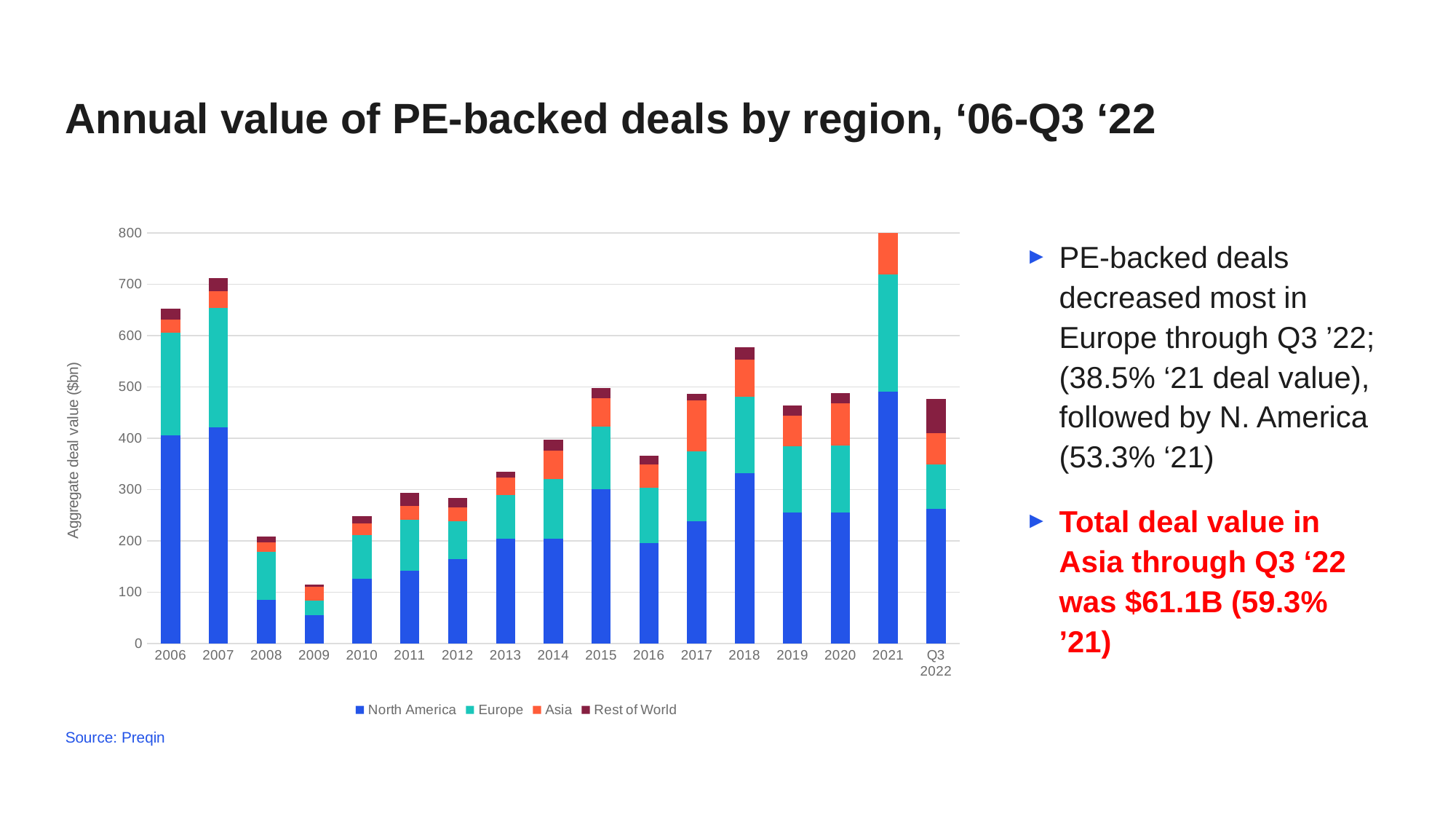
What kind of chart is shown on the slide? Stacked bar chart How many series does the legend list? 4 Do total deal values rise or fall from 2009 to 2015? rise Which year has the lowest total aggregate deal value? 2009 How many bars (time periods) are plotted on the x axis? 17 What is the label on the y axis? Aggregate deal value ($bn) Is the total deal value for 2018 greater or less than 500? greater Is the total deal value for 2016 greater or less than 400? less Which year has a higher total deal value, 2006 or 2007? 2007 Is the total deal value for 2009 greater or less than 200? less Which year has the highest total aggregate deal value? 2021